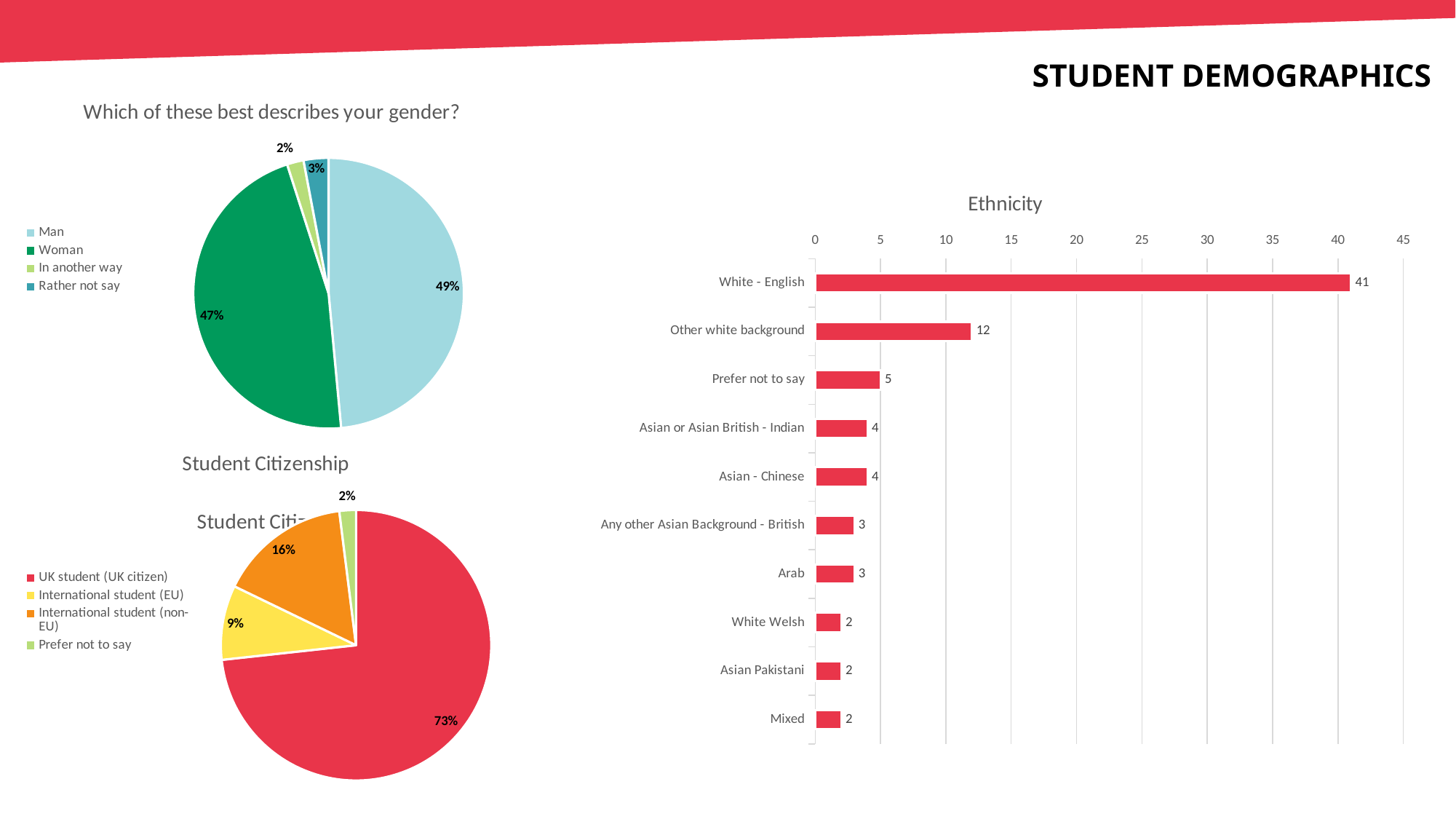
In the gender pie chart, how many categories does the legend list? 4 In the gender pie chart, what is the difference between the Man and Woman shares? 2% In the Student Citizenship pie chart, which category has the smallest share? Prefer not to say In the gender pie chart, what percentage of respondents selected Man? 49% In the gender pie chart, what percentage of respondents selected Woman? 47% In the Student Citizenship pie chart, what share is International student (non-EU)? 16% What type of chart is the Ethnicity chart? Bar chart In the Ethnicity chart, what is the value for Other white background? 12 In the Ethnicity chart, what is the difference between White - English and Other white background? 29 In the Ethnicity chart, what is the value for White - English? 41 In the Student Citizenship pie chart, what share is UK student (UK citizen)? 73% In the Ethnicity chart, which category has the highest value? White - English